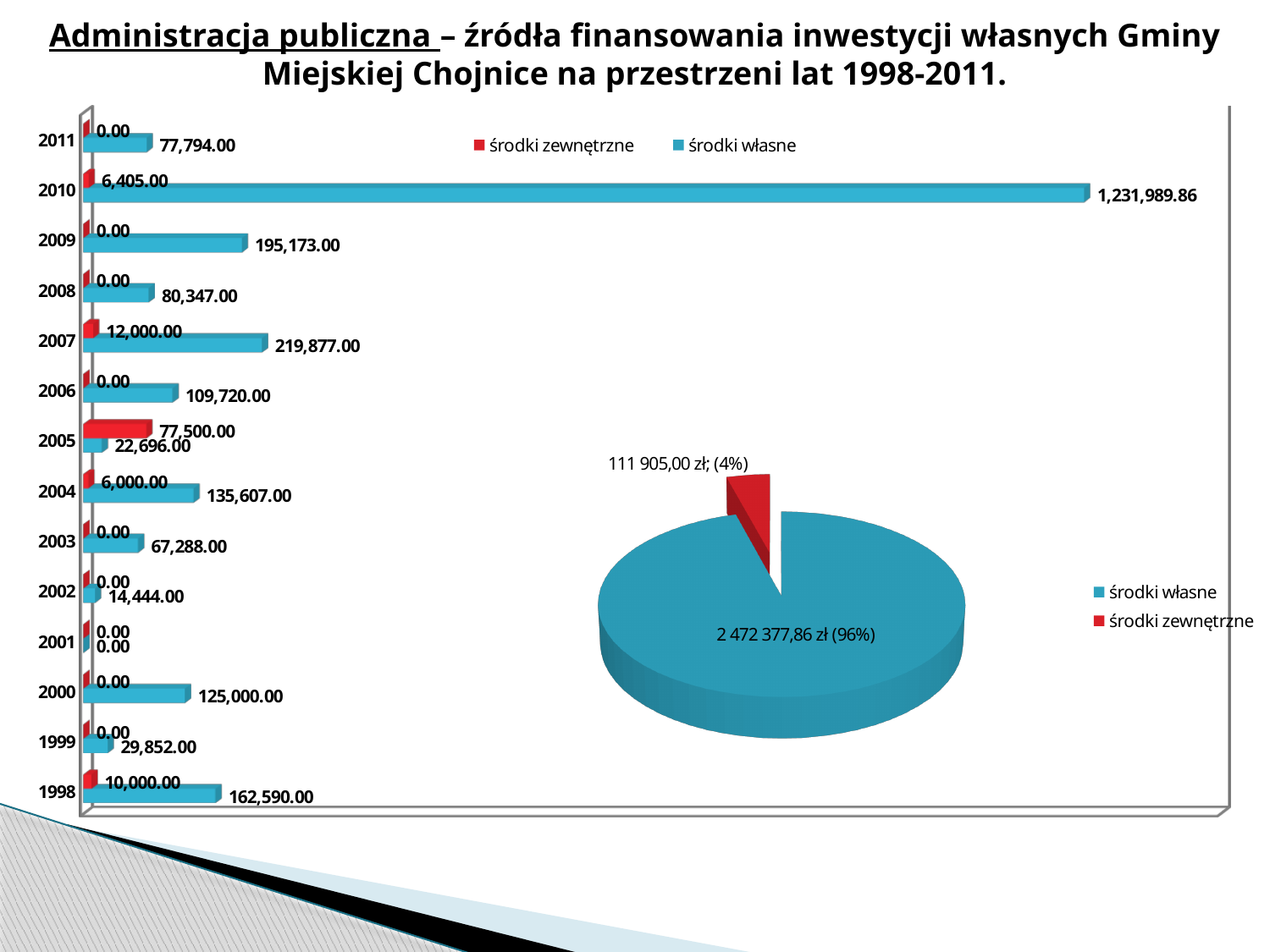
What type of chart is the chart on the left of the slide? bar chart In the bar chart on the left, what is the value of środki własne for 1998? 162,590.00 How many years are shown in the bar chart on the left? 14 In the bar chart on the left, what is the difference between środki własne in 2007 and in 2006? 110,157.00 How many series does the legend of the bar chart on the left list? 2 In the bar chart on the left, which is larger in 2005: środki zewnętrzne or środki własne? środki zewnętrzne In the bar chart on the left, which year has the highest value of środki własne? 2010 In the bar chart on the left, what is the value of środki własne for 2010? 1,231,989.86 In the pie chart on the right, what is the value shown for środki własne? 2 472 377,86 zł In the bar chart on the left, what is the value of środki zewnętrzne for 2005? 77,500.00 In the pie chart on the right, what share does środki zewnętrzne have? 4% In the bar chart on the left, which year has the highest value of środki zewnętrzne? 2005